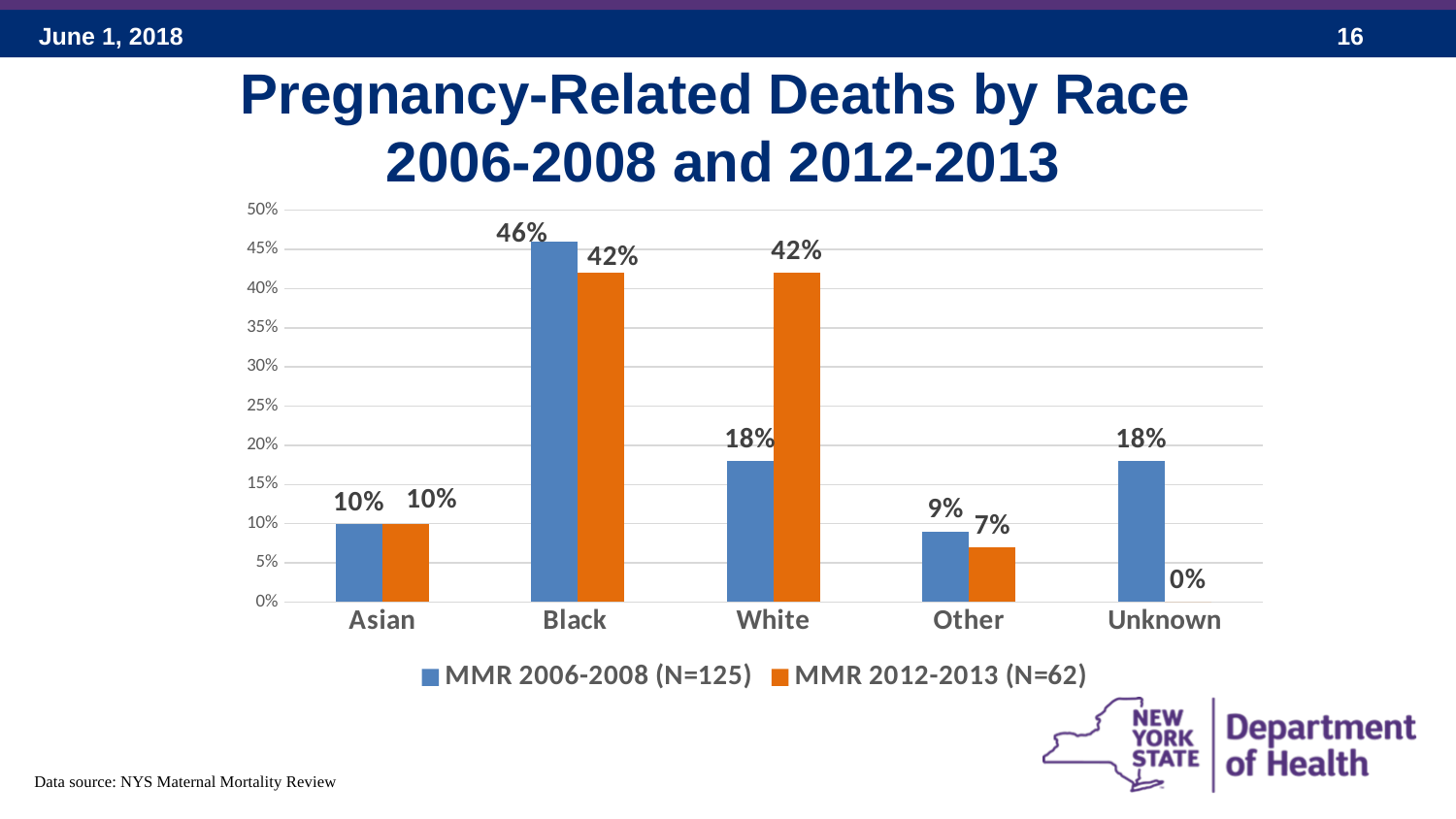
What is the value for Black in the MMR 2006-2008 (N=125) series? 46% What is the difference between the MMR 2012-2013 and MMR 2006-2008 values for White? 24 percentage points What is the value for White in the MMR 2012-2013 (N=62) series? 42% Which race category has the lowest value in the MMR 2012-2013 (N=62) series? Unknown What colour represents the MMR 2012-2013 (N=62) series? Orange What is the value for Unknown in the MMR 2012-2013 (N=62) series? 0% For Other, which series has the larger value, MMR 2006-2008 (N=125) or MMR 2012-2013 (N=62)? MMR 2006-2008 (N=125) Which race category has the highest value in the MMR 2006-2008 (N=125) series? Black How many race categories are shown on the x axis? 5 How many series does the legend list? 2 What is the title of the chart? Pregnancy-Related Deaths by Race 2006-2008 and 2012-2013 What kind of chart is shown on the slide? Bar chart